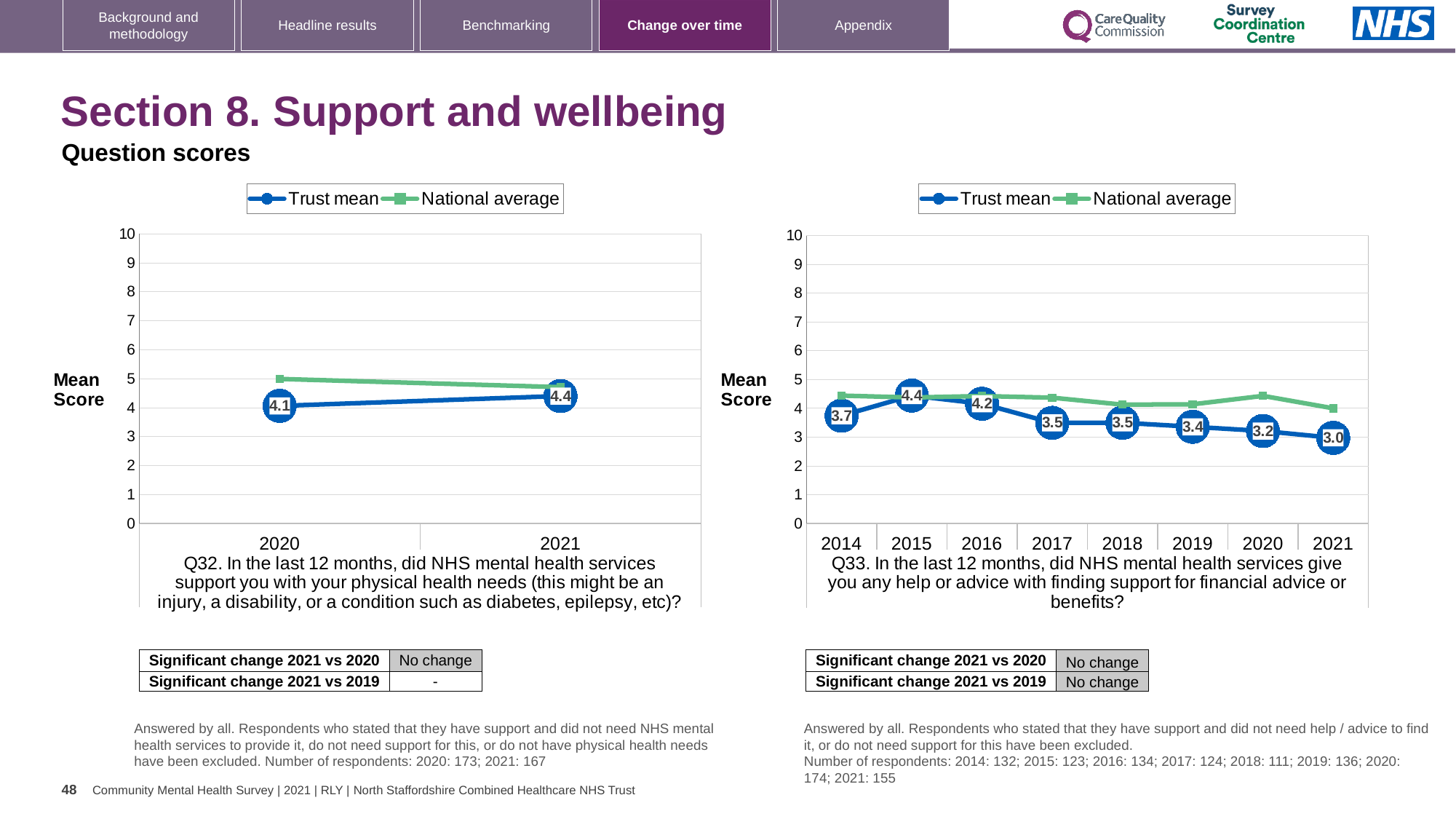
In the Q32 chart on the left, what is the Trust mean for 2020? 4.1 In the Q33 chart on the right, what is the Trust mean for 2021? 3.0 In the Q33 chart on the right, what is the difference between the Trust mean in 2015 and in 2021? 1.4 In the Q32 chart on the left, what is the difference between the Trust mean in 2021 and in 2020? 0.3 In the Q33 chart on the right, how many years are shown on the x axis? 8 In the Q33 chart on the right, does the Trust mean rise or fall from 2016 to 2021? fall In the Q32 chart on the left, is the National average for 2020 greater or less than 4? greater In the Q32 chart on the left, what is the Trust mean for 2021? 4.4 In the Q33 chart on the right, which is larger, the Trust mean for 2016 or for 2019? 2016 In the Q33 chart on the right, which year has the lowest Trust mean? 2021 How many series does the legend of the Q32 chart on the left list? 2 In the Q33 chart on the right, which year has the highest Trust mean? 2015